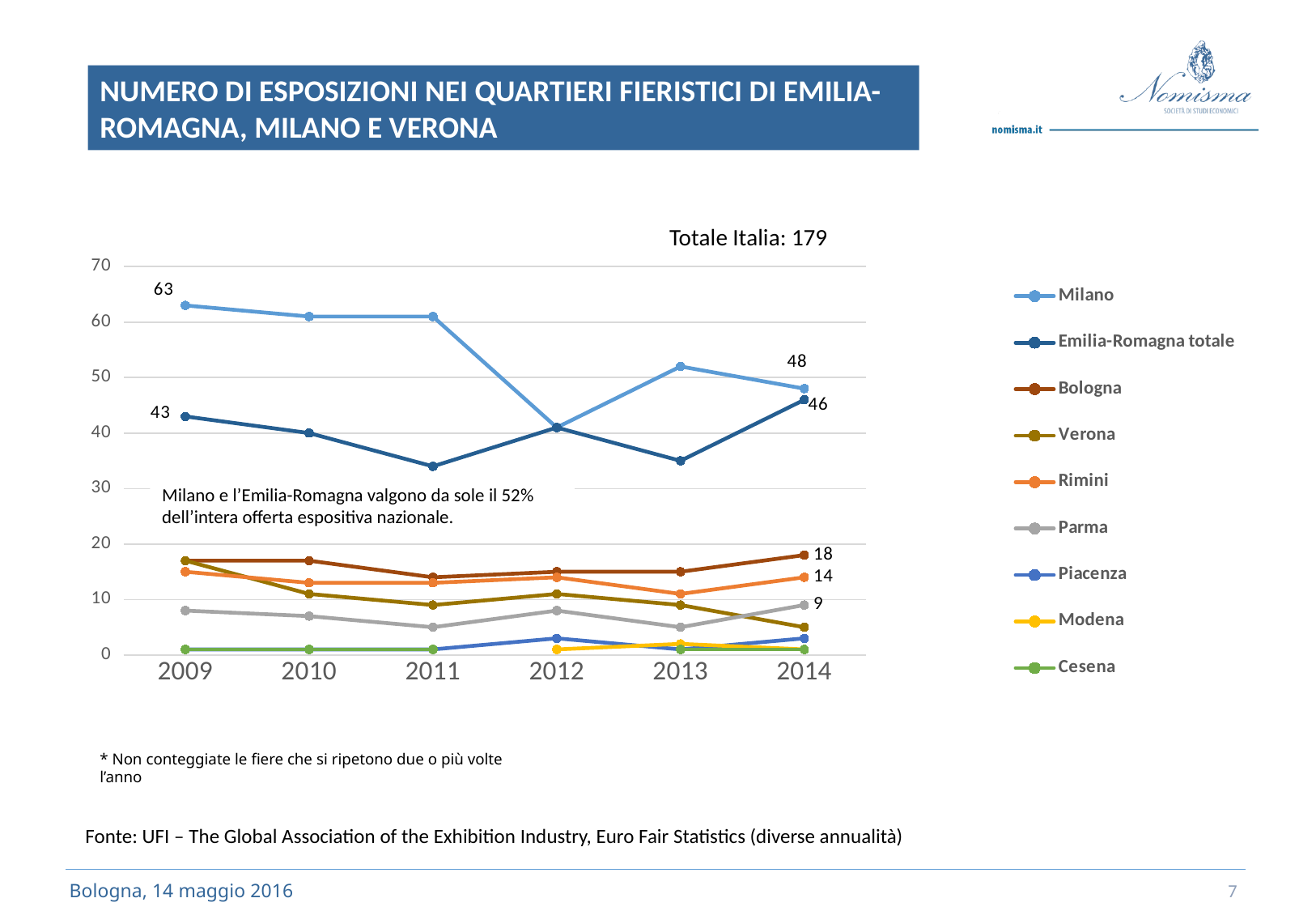
What is the value for Emilia-Romagna totale in 2009? 43 How many years are shown on the x axis? 6 What is the value for Milano in 2014? 48 By how much did the value for Milano fall between 2009 and 2014? 15 What is the value for Milano in 2009? 63 What is the value for Bologna in 2014? 18 In 2014, which is larger: Milano or Emilia-Romagna totale? Milano Is the value for Emilia-Romagna totale in 2011 greater or less than 40? less What kind of chart is shown on the slide? line chart How many series does the legend list? 9 What is the value for Parma in 2014? 9 What total for Italy is stated above the chart? 179